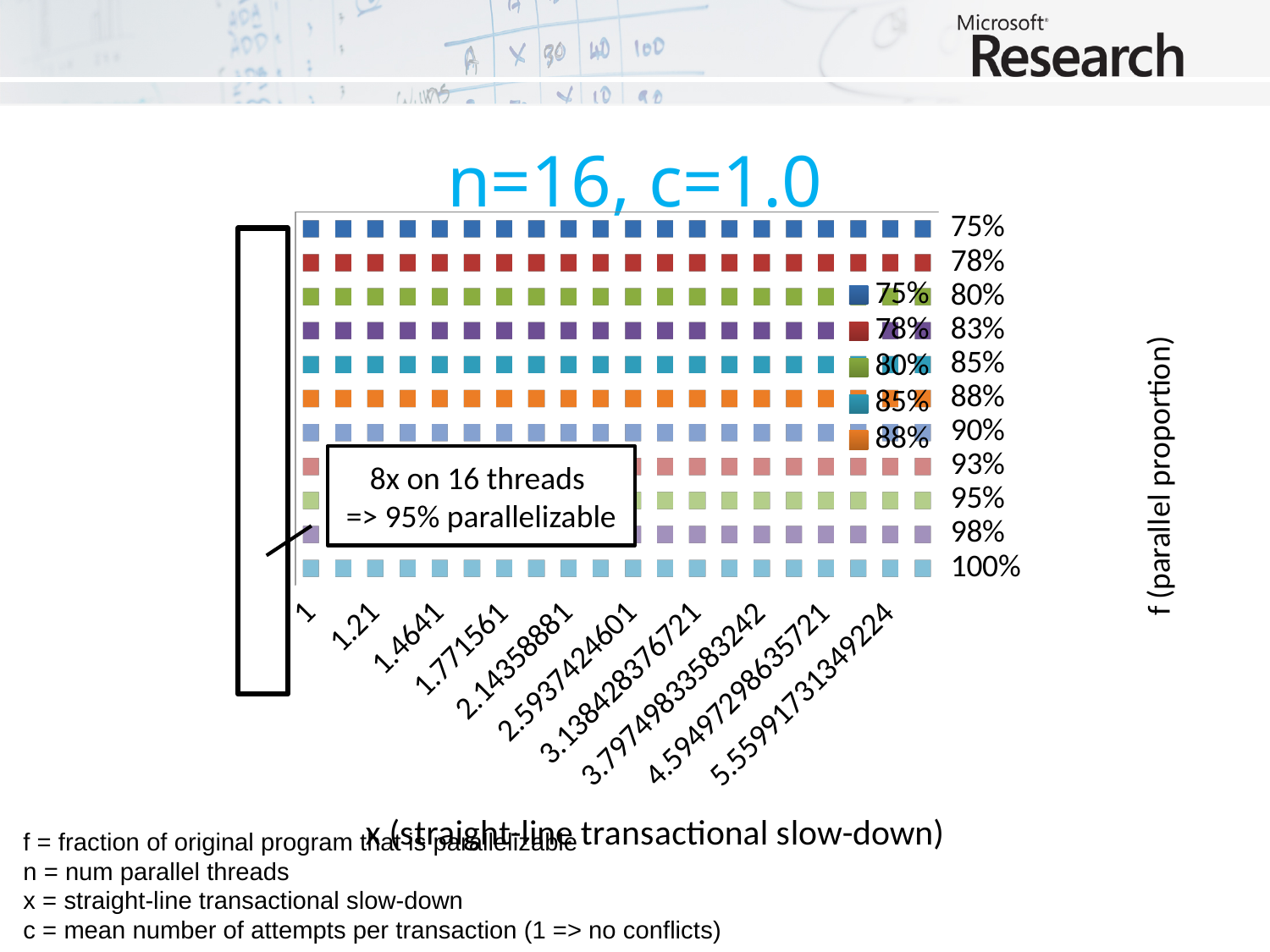
How many tick labels are shown along the x axis of the chart? 10 What kind of chart is shown on the slide? surface chart What is the title of the chart? n=16, c=1.0 What is the label on the x axis of the chart? x (straight-line transactional slow-down) What is the second x-axis tick label on the chart? 1.21 How many f (parallel proportion) values are listed down the right side of the chart? 11 What is the first (leftmost) x-axis tick label on the chart? 1 What is the largest f (parallel proportion) value listed on the right side of the chart? 100% What is the smallest f (parallel proportion) value listed on the right side of the chart? 75%